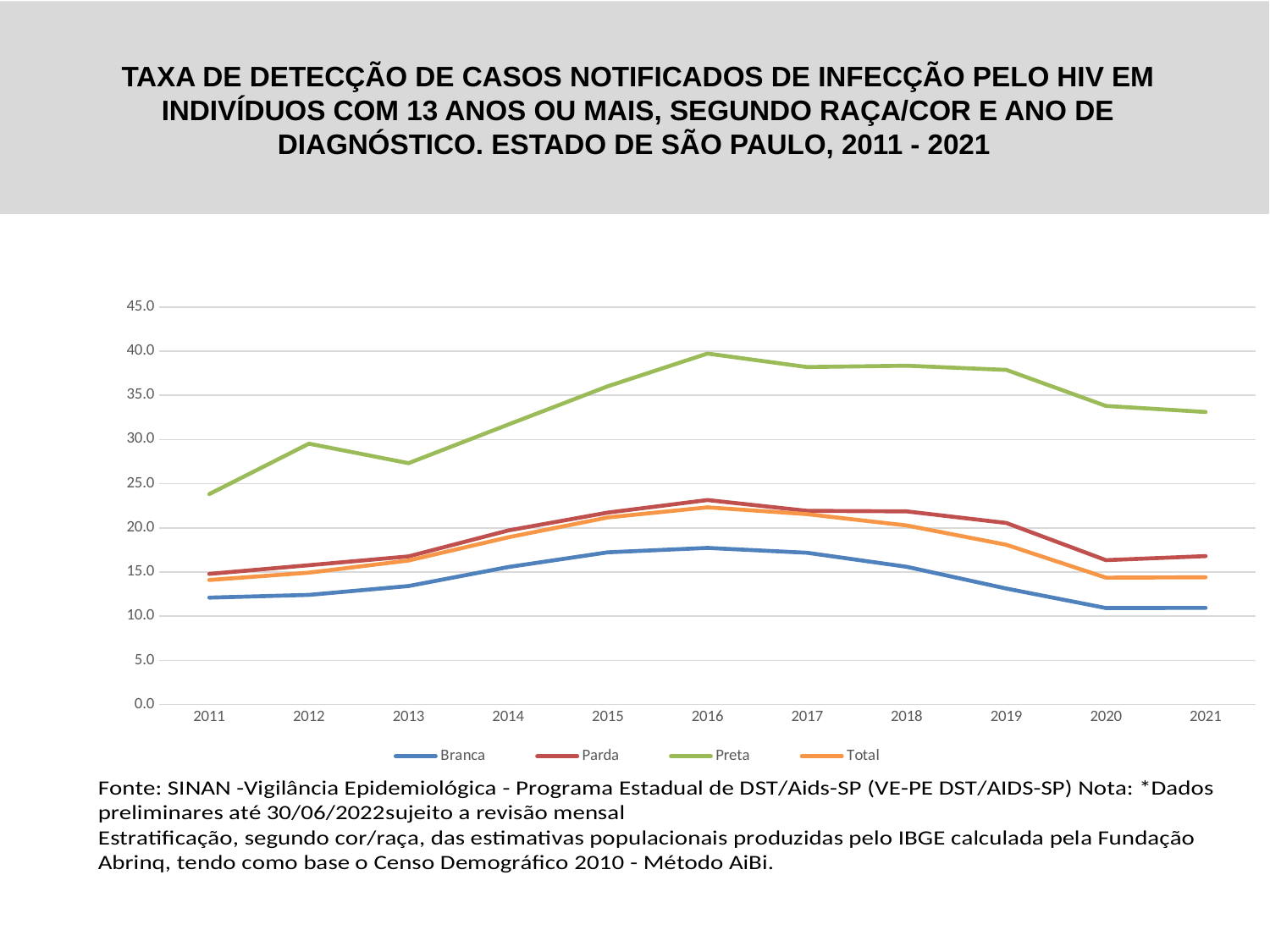
Is the value for Preta in 2016 greater or less than 35.0? greater Which series has the lowest value in 2021? Branca Does the Branca series rise or fall from 2016 to 2021? fall Which is larger in 2019, the value for Parda or the value for Branca? Parda What kind of chart is shown on the slide? line chart Which is larger for Preta, the value in 2012 or the value in 2013? 2012 Is the value for Parda in 2016 greater or less than 20.0? greater Is the value for Branca in 2021 greater or less than 15.0? less What colour is the Preta line in the legend? green Which series has the highest value in 2016? Preta How many years are plotted along the x axis? 11 How many series does the legend list? 4